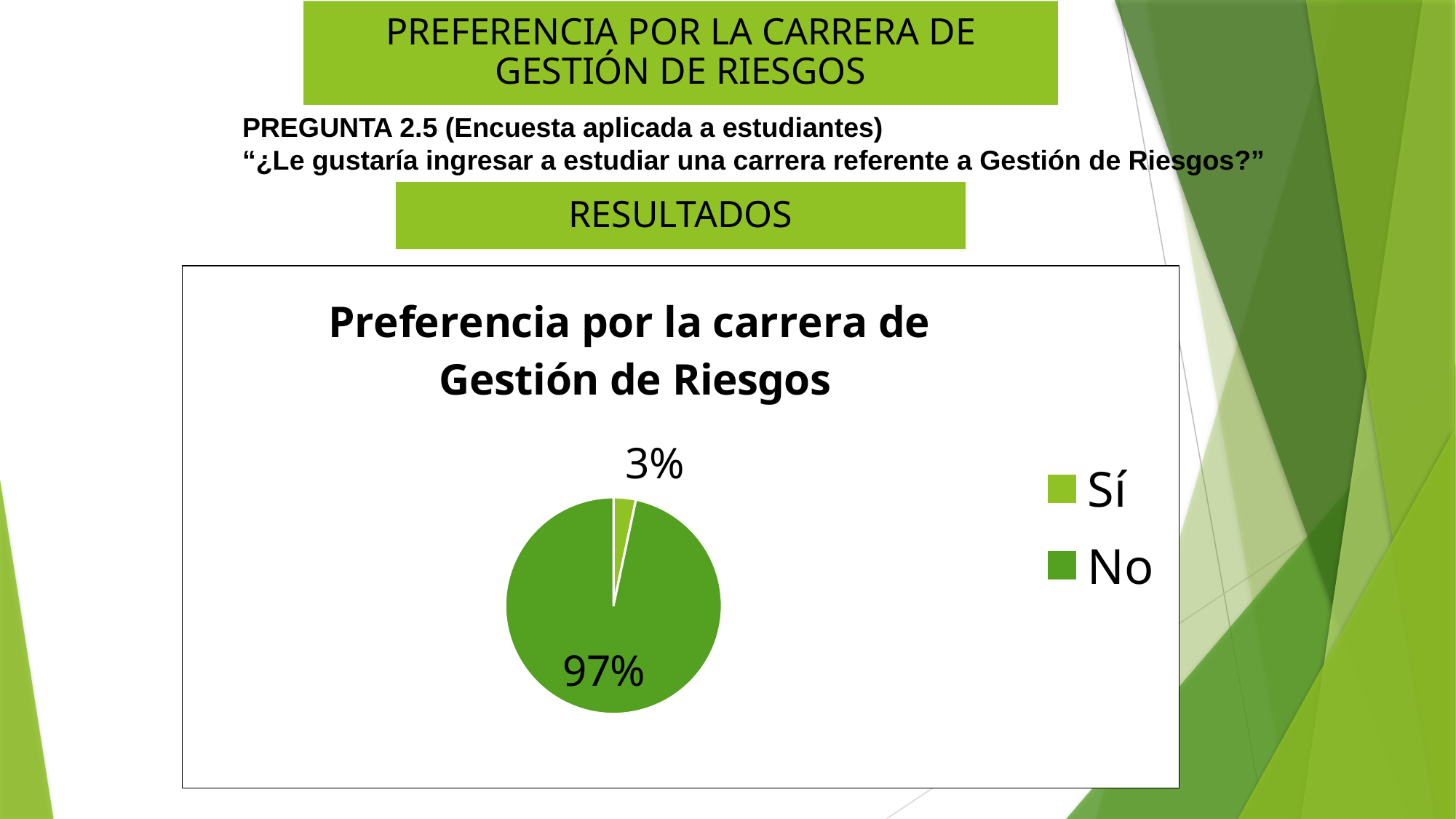
What is the difference in percentage points between the "No" and "Sí" slices? 94 Which slice is larger, "Sí" or "No"? No What percentage of the pie chart corresponds to "Sí"? 3% How many entries does the legend list? 2 Which category has the smallest share of the pie chart? Sí What is the title of the chart? Preferencia por la carrera de Gestión de Riesgos What kind of chart is shown on the slide? Pie chart Which category has the largest share of the pie chart? No How many categories does the pie chart show? 2 What percentage of the pie chart corresponds to "No"? 97% What share of the pie does the "Sí" slice represent? 3% Which legend entry is shown in the darker green colour? No